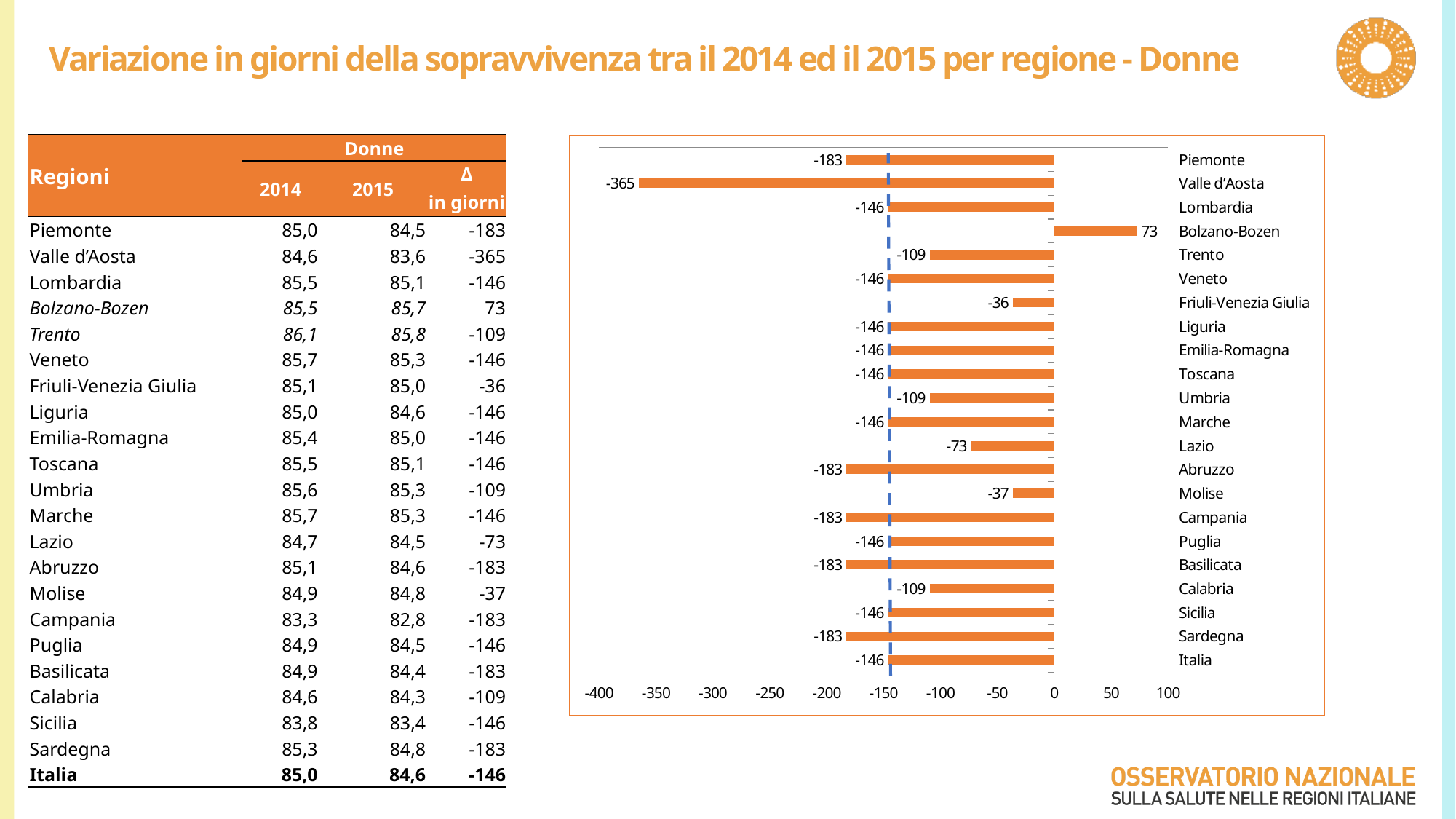
Which has a larger value in the chart, Molise or Abruzzo? Molise What is the value shown for Italia in the chart? -146 What colour are the bars in the chart? orange Which region has the lowest value in the chart? Valle d'Aosta How many regions (bars) are shown in the chart? 22 What is the difference between the values for Bolzano-Bozen and Valle d'Aosta in the chart? 438 Is the value for Valle d'Aosta in the chart greater or less than -300? less What is the value shown for Friuli-Venezia Giulia in the chart? -36 What is the value shown for Valle d'Aosta in the chart? -365 What kind of chart is shown on the slide? bar chart What is the value shown for Bolzano-Bozen in the chart? 73 Which region has the highest value in the chart? Bolzano-Bozen